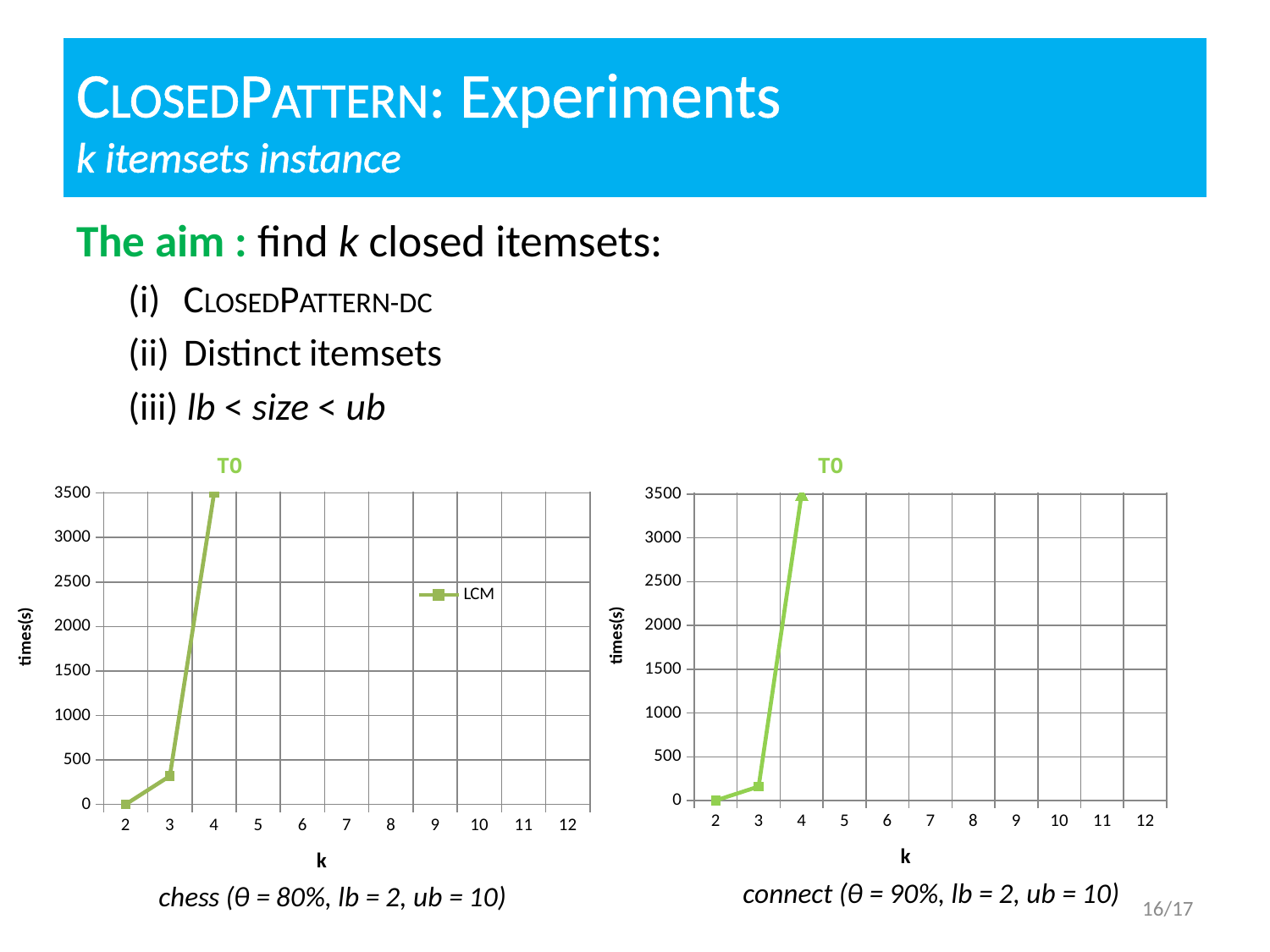
In the left chart (chess), is the value at k = 3 greater or less than 500? less What is the title of the left chart (chess)? T0 In the right chart (connect), at which value of k is the plotted time lowest? 2 In the left chart (chess), do the values rise or fall as k goes from 2 to 4? rise In the left chart (chess), which has the larger value, k = 3 or k = 4? k = 4 In the left chart (chess), is the value at k = 4 greater or less than 3000? greater In the right chart (connect), is the value at k = 4 greater or less than 3000? greater How many series does the legend of the left chart (chess) list? 1 In the right chart (connect), at which value of k is the plotted time highest? 4 What is the name of the series shown in the legend of the left chart (chess)? LCM What kind of chart is the left chart (chess)? line chart